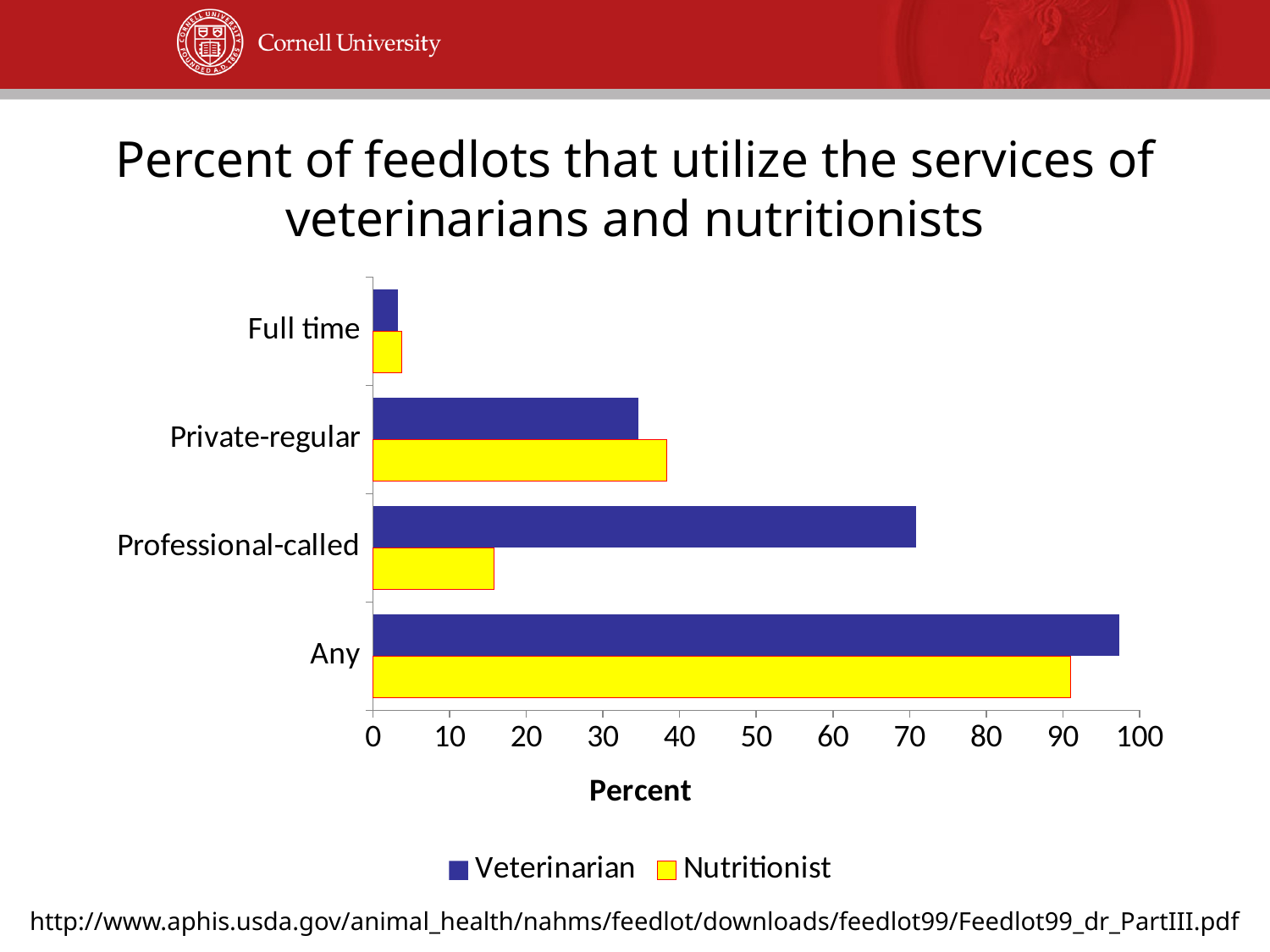
For Professional-called, which is larger: Veterinarian or Nutritionist? Veterinarian Which category has the highest Veterinarian value? Any For Private-regular, which is larger: Veterinarian or Nutritionist? Nutritionist What kind of chart is shown on the slide? bar chart Is the Nutritionist value for Professional-called greater or less than 20? less Is the Veterinarian value for Professional-called greater or less than 60? greater Is the Nutritionist value for Any greater or less than 80? greater How many categories are shown on the vertical axis? 4 Which category has the highest Nutritionist value? Any What is the label of the horizontal axis? Percent Which category has the lowest Nutritionist value? Full time How many series does the legend list? 2